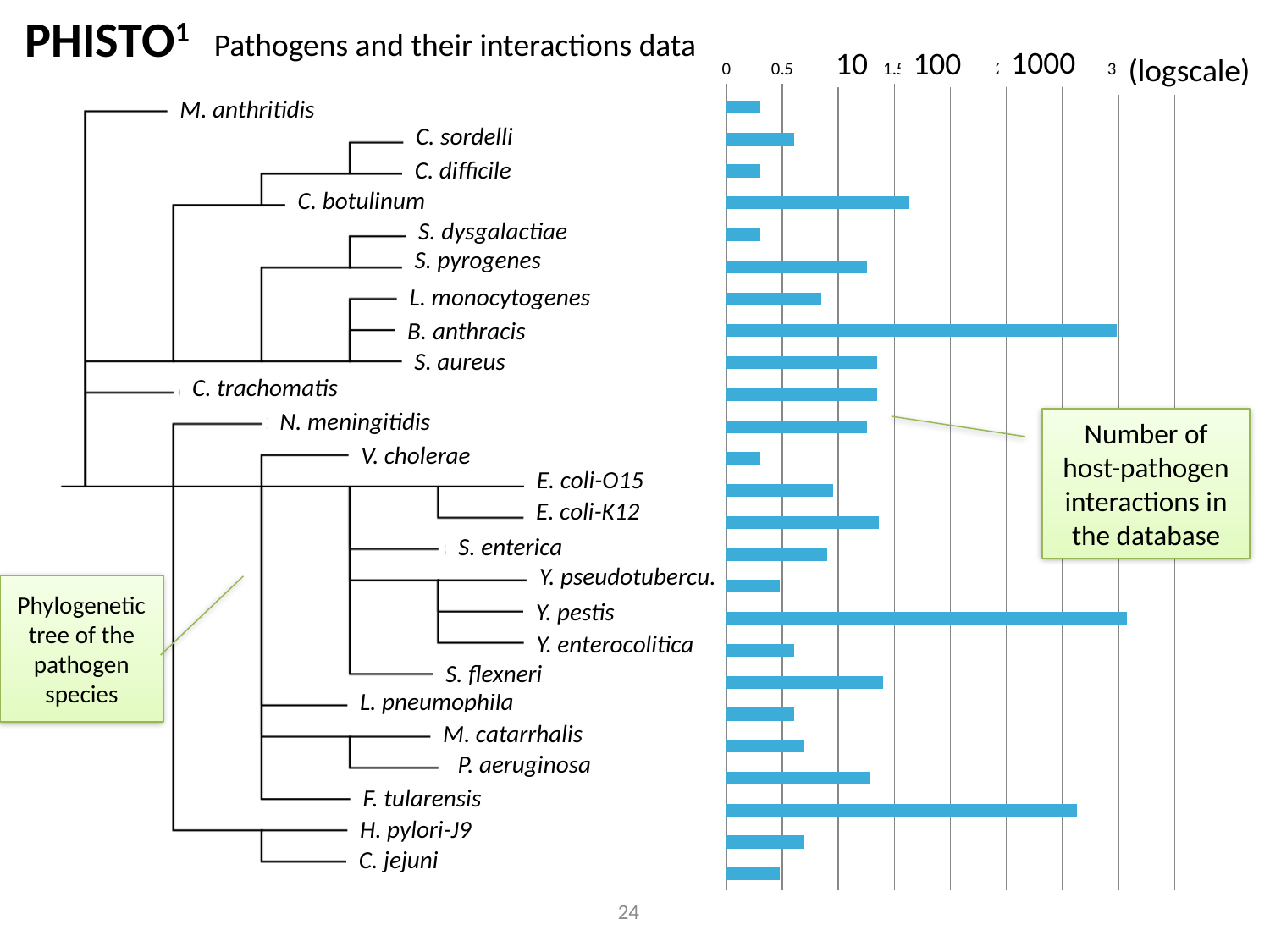
Which has more host-pathogen interactions, F. tularensis or H. pylori-J9? F. tularensis According to the callout, what do the bars represent? Number of host-pathogen interactions in the database How many pathogen species have bars in the chart? 25 Is the value for C. sordelli greater or less than 10? less Which has more host-pathogen interactions, B. anthracis or C. sordelli? B. anthracis Which has more host-pathogen interactions, Y. pestis or Y. pseudotubercu.? Y. pestis What kind of chart is shown on the slide? bar chart What scale is used on the chart's horizontal axis? logscale Is the value for C. botulinum greater or less than 10? greater Is the value for B. anthracis greater or less than 1000? greater